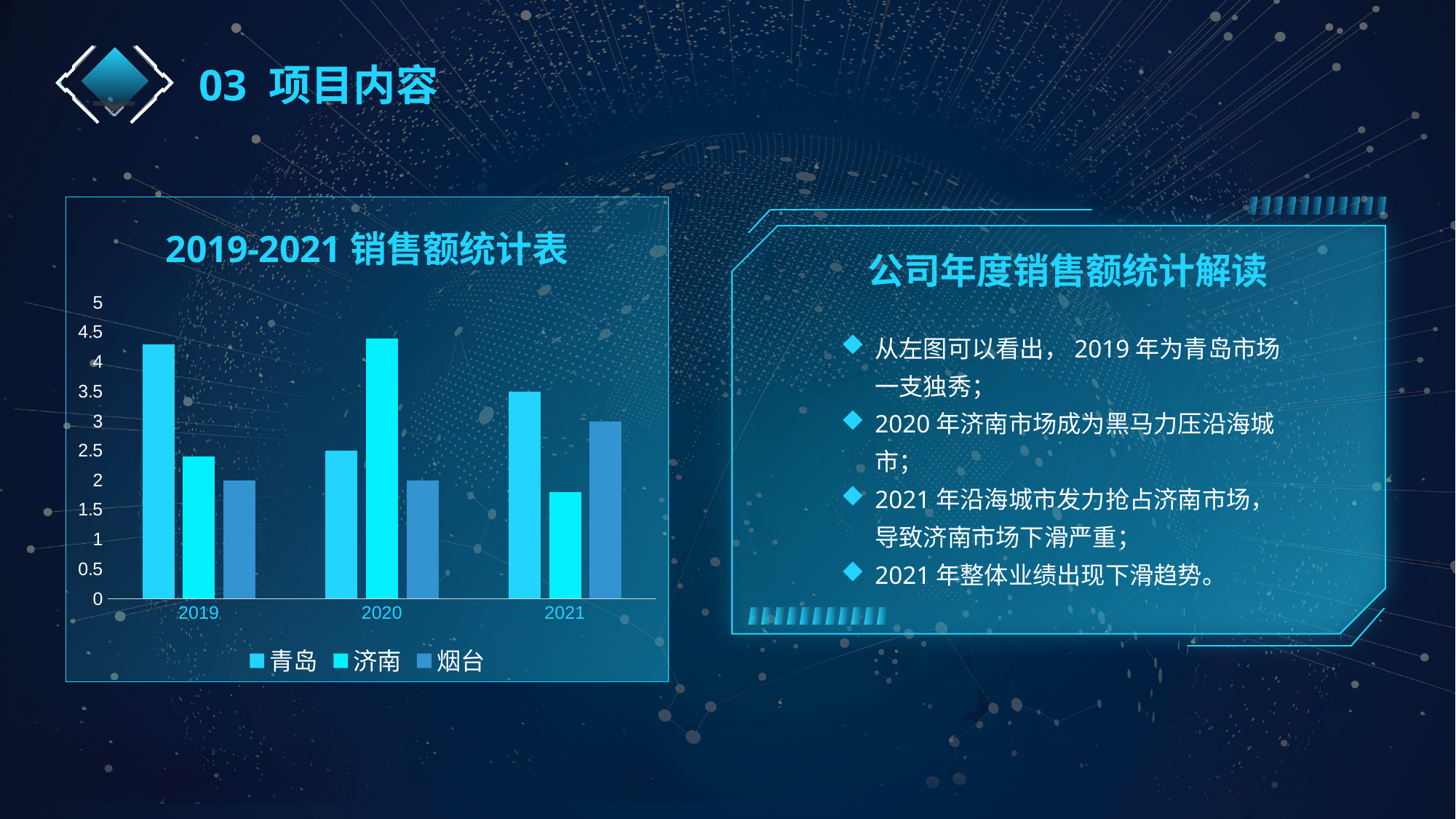
Is the value for 济南 in 2020 greater or less than 4? greater What is the title of the chart? 2019-2021 销售额统计表 How many series does the chart legend list? 3 How many years are shown on the x axis of the chart? 3 Which city has the highest value in 2020? 济南 Which city has the highest value in 2019? 青岛 What kind of chart is shown on the slide? bar chart Which city has the lowest value in 2021? 济南 In 2021, which is larger, the value for 青岛 or the value for 烟台? 青岛 Is the value for 济南 in 2021 greater or less than 2? less Is the value for 青岛 in 2019 greater or less than 4? greater What is the value for 烟台 in 2021? 3